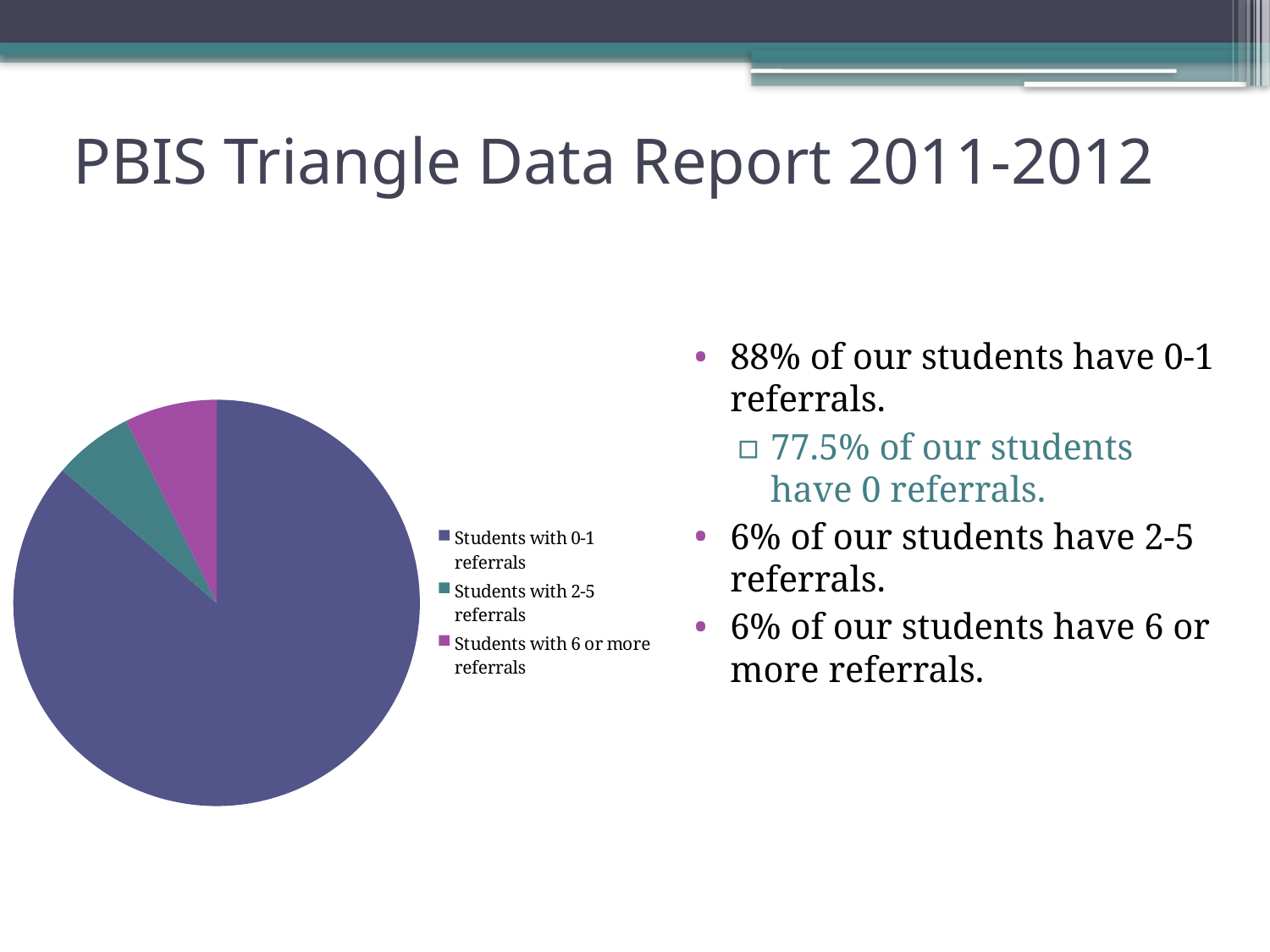
How many entries does the pie chart's legend list? 3 According to the slide, what share of students have 0-1 referrals? 88% What kind of chart is shown on the slide? pie chart What is the title of the slide containing the pie chart? PBIS Triangle Data Report 2011-2012 Does the slice for Students with 0-1 referrals cover more or less than half of the pie? more Which colour represents Students with 6 or more referrals in the pie chart's legend? purple/magenta Is the slice for Students with 0-1 referrals larger or smaller than the slice for Students with 2-5 referrals? larger How many slices does the pie chart have? 3 Is the slice for Students with 6 or more referrals larger or smaller than the slice for Students with 0-1 referrals? smaller Which category takes up the largest slice of the pie chart? Students with 0-1 referrals According to the slide, what share of students have 2-5 referrals? 6% According to the slide, what share of students have 6 or more referrals? 6%